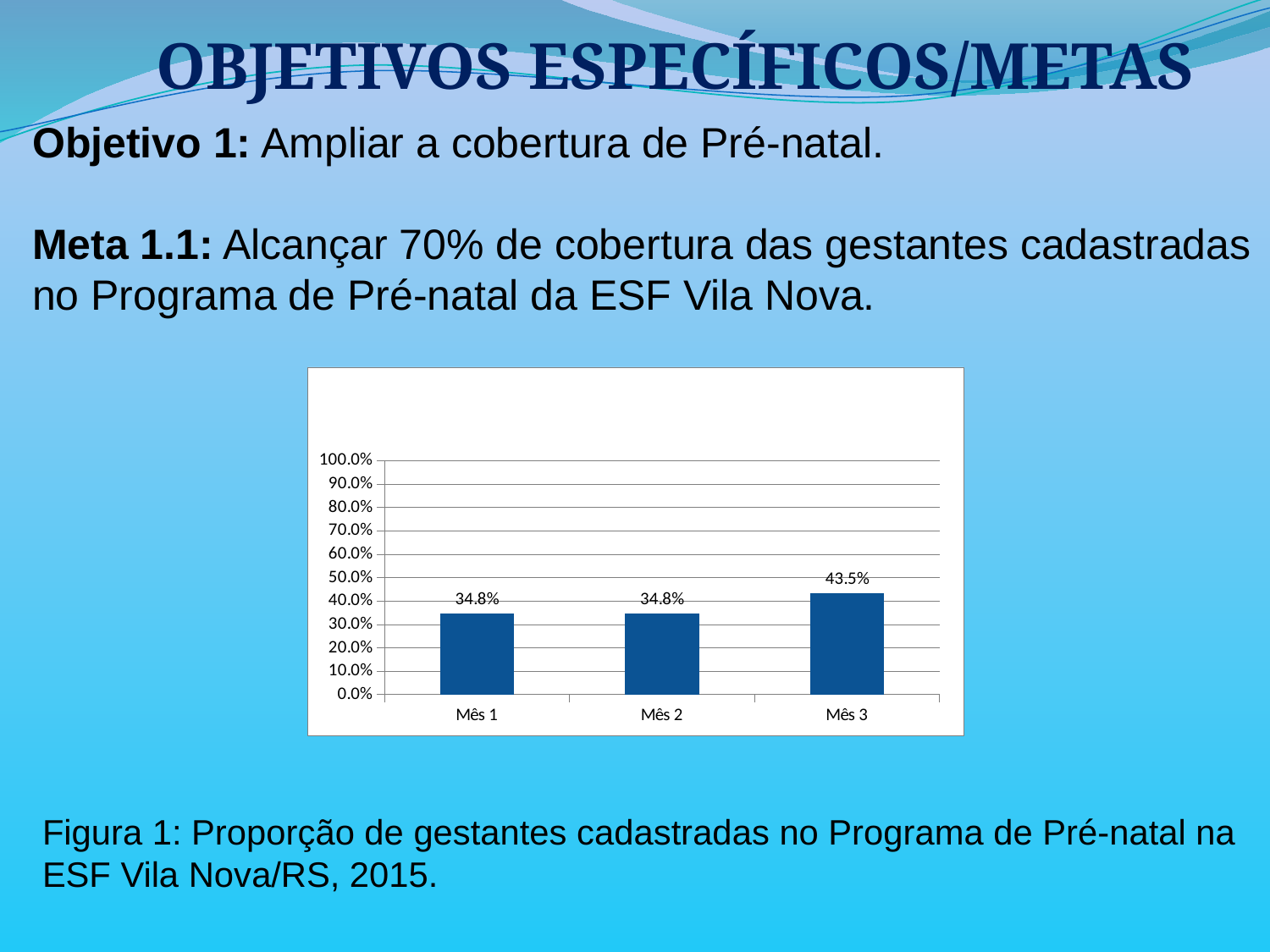
Is the value for Mês 2 greater or less than 30.0%? greater Do Mês 1 and Mês 2 have the same value? Yes How many months are shown on the x axis? 3 What kind of chart is shown on the slide? Bar chart Which month has the highest value? Mês 3 What is the value for Mês 1? 34.8% Is the value for Mês 3 greater or less than 50.0%? less What is the highest value shown on the y axis? 100.0% What is the value for Mês 3? 43.5% Do the values rise or fall from Mês 2 to Mês 3? Rise What is the difference between the values for Mês 3 and Mês 2? 8.7% Which is larger, the value for Mês 1 or the value for Mês 3? Mês 3